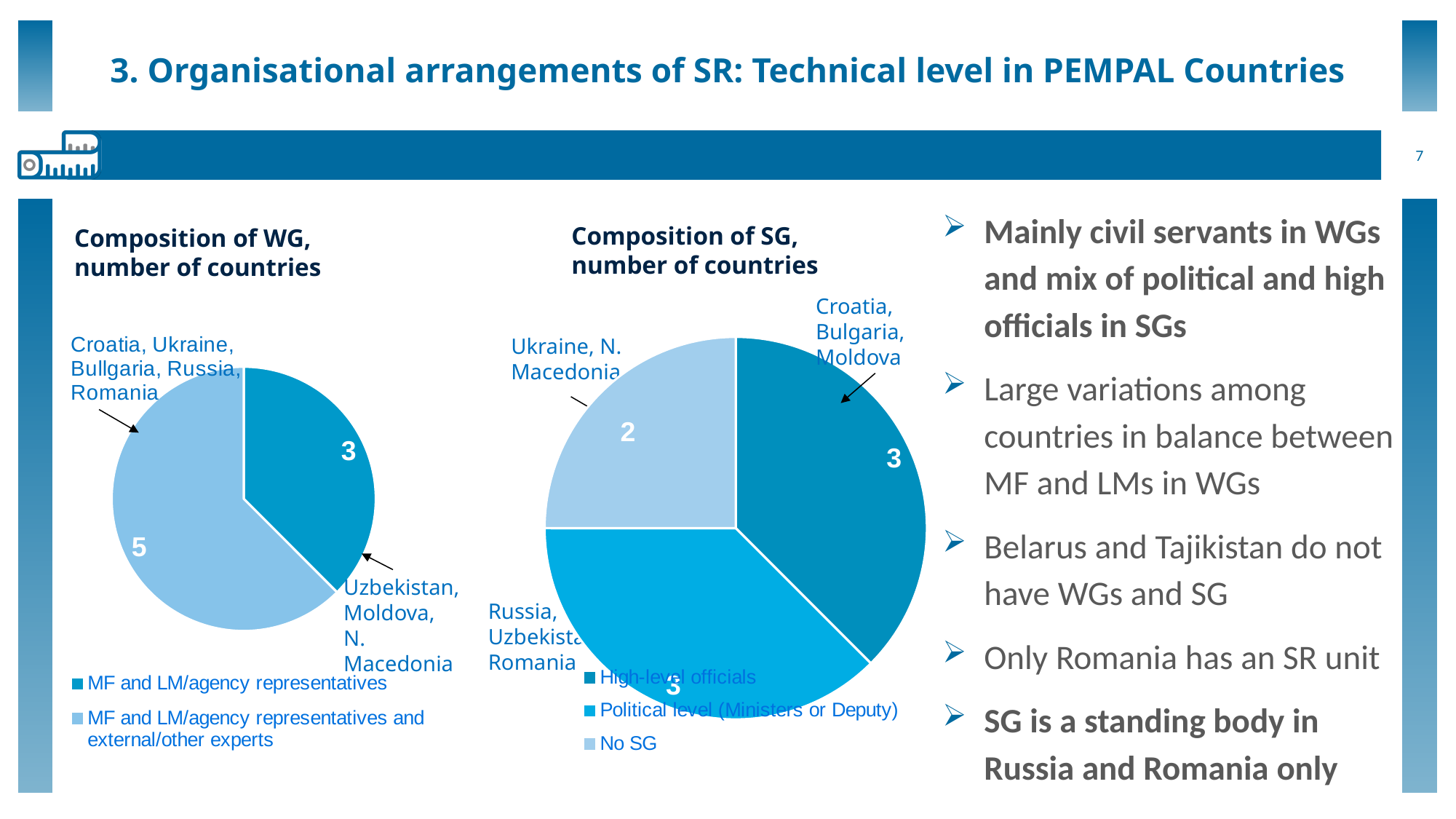
How many entries does the legend of the 'Composition of SG, number of countries' chart list? 3 In the 'Composition of SG, number of countries' chart, which category has the smallest number of countries? No SG In the 'Composition of SG, number of countries' chart, how many countries have no SG? 2 In the 'Composition of WG, number of countries' chart, which category has the larger number of countries? MF and LM/agency representatives and external/other experts In the 'Composition of SG, number of countries' chart, how many countries have high-level officials in the SG? 3 In the 'Composition of WG, number of countries' chart, how many countries have MF and LM/agency representatives and external/other experts? 5 In the 'Composition of WG, number of countries' chart, how many countries have only MF and LM/agency representatives? 3 In the 'Composition of WG, number of countries' chart, what is the difference between the two slices? 2 In the 'Composition of WG, number of countries' chart, what share of the pie is the slice with 5 countries? 62.5% What kind of chart is the 'Composition of WG, number of countries' chart? pie chart In the 'Composition of SG, number of countries' chart, what share of the pie is the 'No SG' slice? 25% How many slices does the 'Composition of SG, number of countries' pie chart have? 3